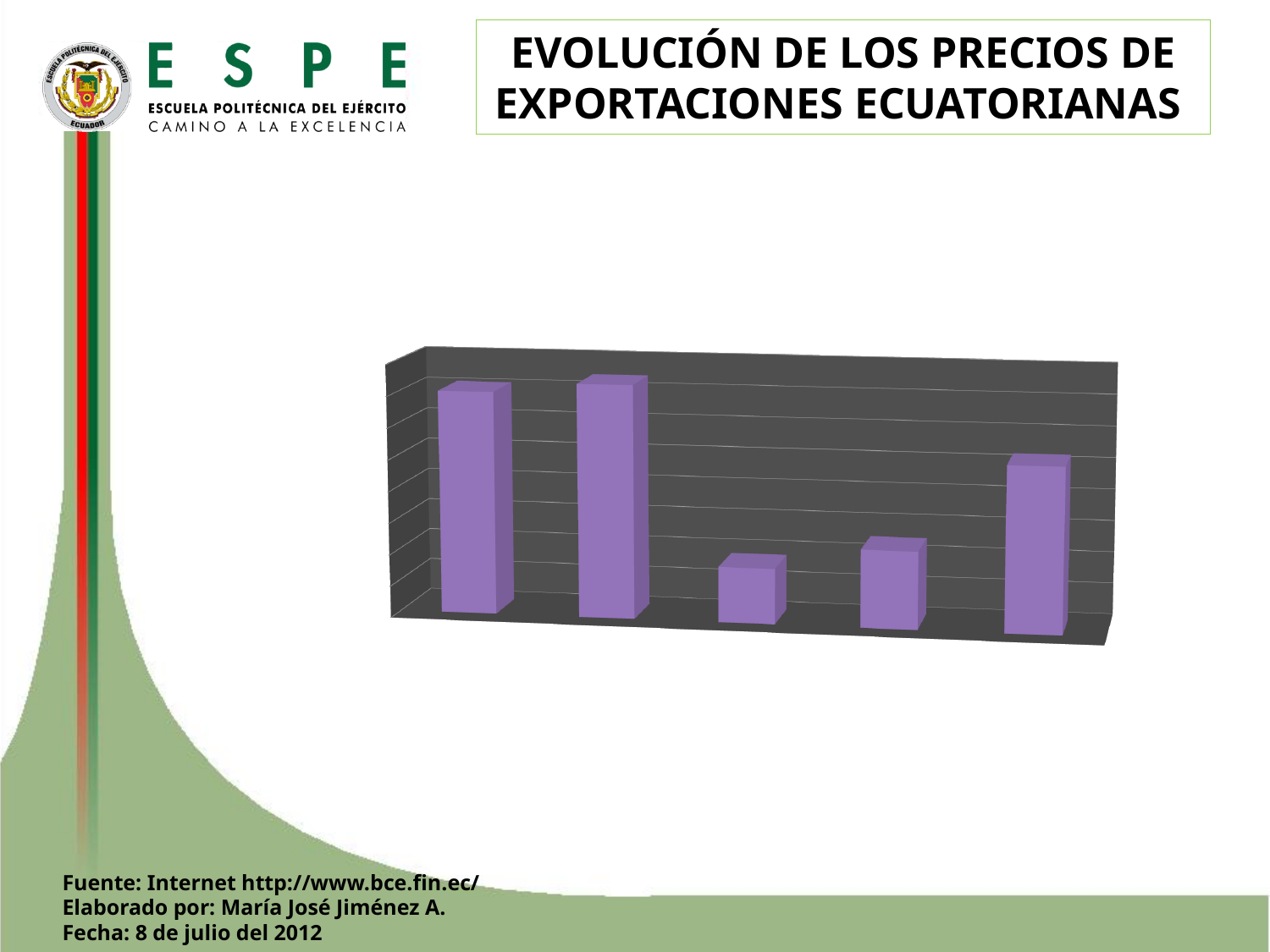
Is the fifth bar from the left taller or shorter than the first bar? shorter Is the fourth bar from the left taller or shorter than the second bar? shorter Which bar in the chart is the shortest, counting from the left? the third bar What kind of chart is shown on the slide? bar chart How many bars are plotted in the chart? 5 What colour are the bars in the chart? purple What is the title shown above the chart on the slide? EVOLUCIÓN DE LOS PRECIOS DE EXPORTACIONES ECUATORIANAS Is the fifth bar from the left taller or shorter than the fourth bar? taller